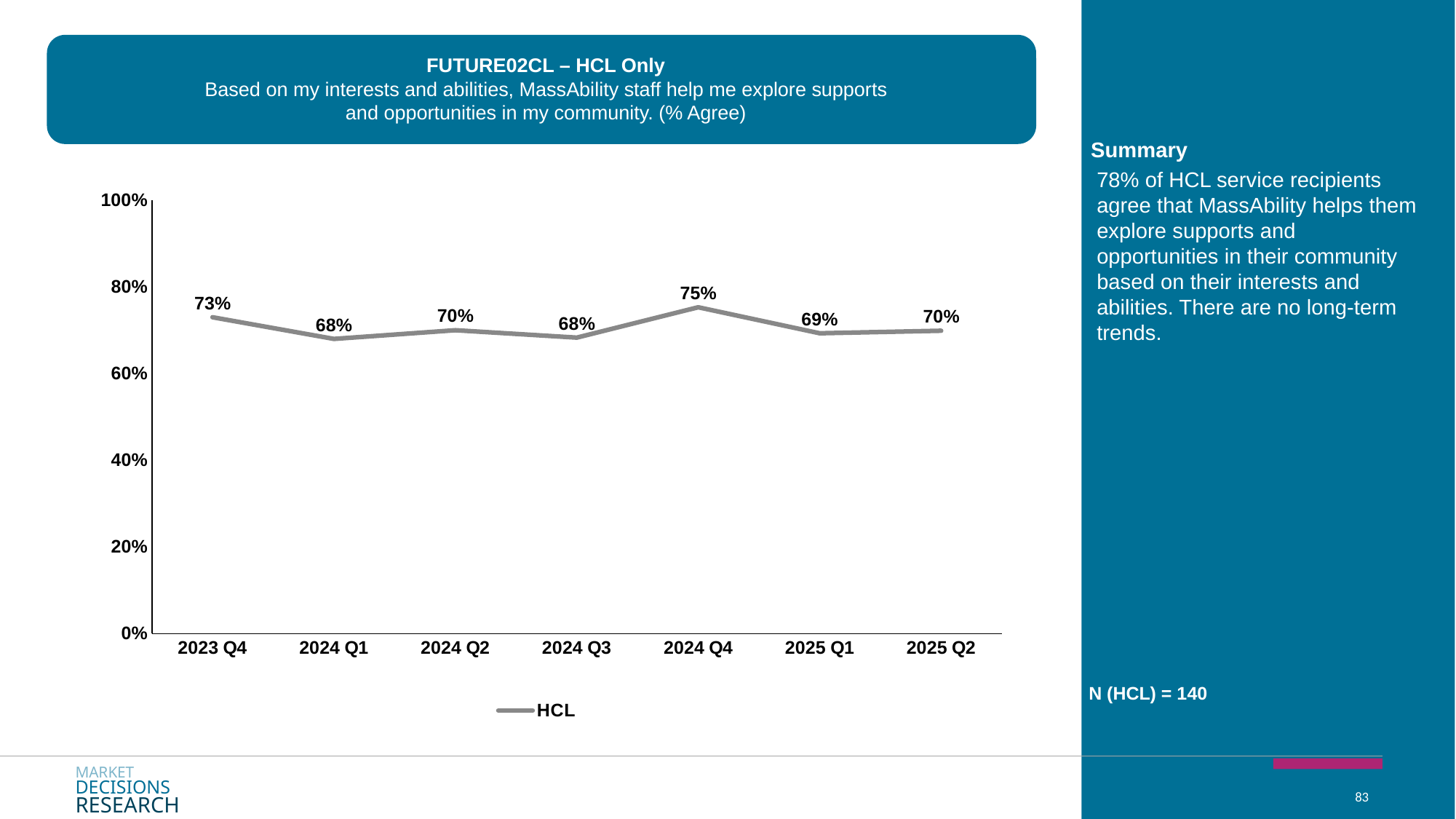
Which is larger, the HCL value for 2023 Q4 or for 2025 Q1? 2023 Q4 What is the value for HCL in 2023 Q4? 73% What kind of chart is shown on the slide? Line chart What is the difference between the HCL values for 2024 Q4 and 2024 Q3? 7% What is the difference between the HCL values for 2023 Q4 and 2024 Q1? 5% Which quarter has the highest value for HCL? 2024 Q4 How many series does the legend list? 1 How many quarters are plotted on the x axis? 7 What is the value for HCL in 2024 Q4? 75% Is the value for HCL in 2024 Q4 greater or less than 60%? greater What is the value for HCL in 2025 Q2? 70% What is the name of the series shown in the legend? HCL